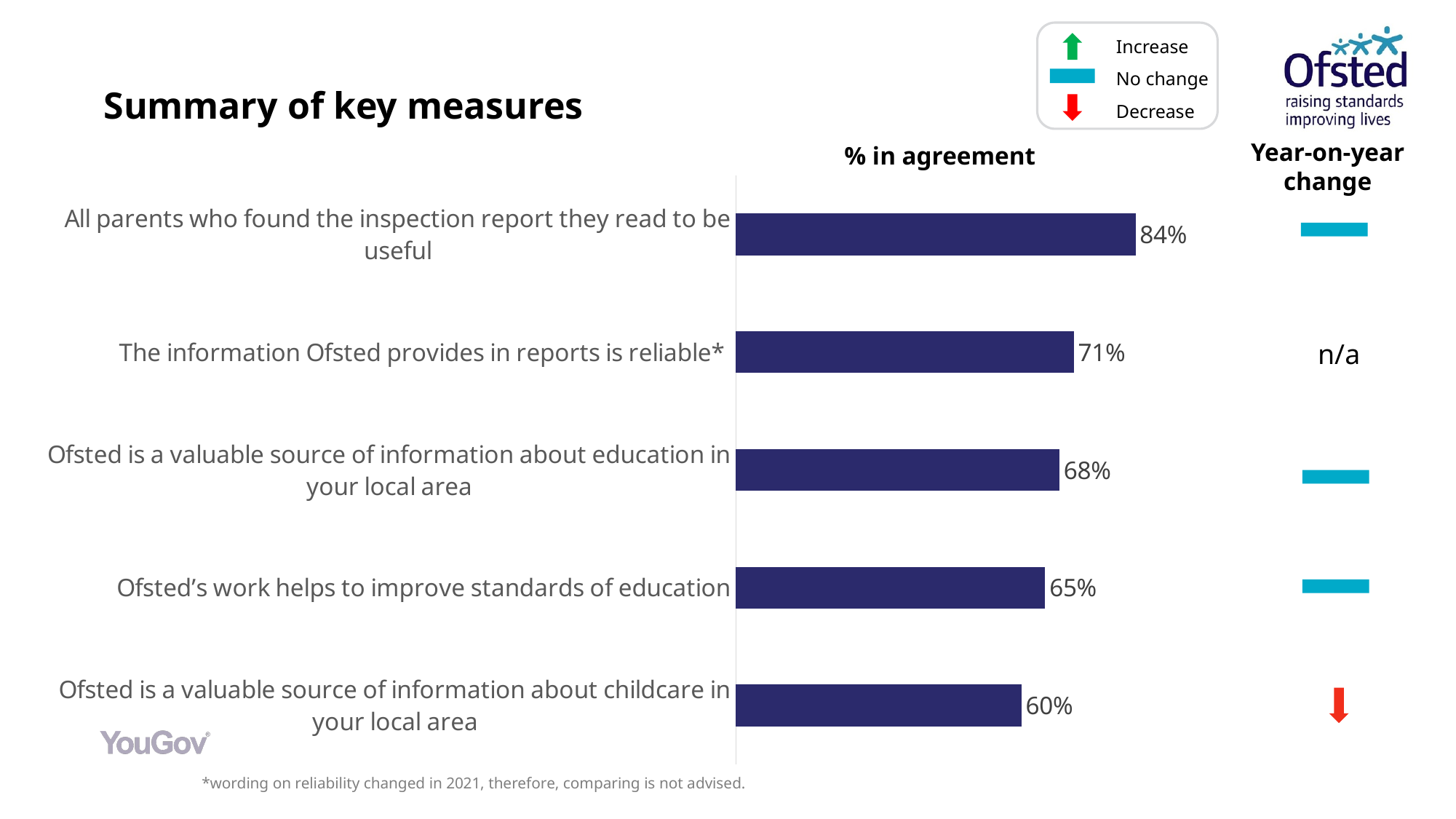
Which measure has the lowest % in agreement? Ofsted is a valuable source of information about childcare in your local area What is the difference in % in agreement between 'All parents who found the inspection report they read to be useful' and 'Ofsted is a valuable source of information about childcare in your local area'? 24% What kind of chart is shown on the slide? Bar chart What is the % in agreement for 'Ofsted is a valuable source of information about childcare in your local area'? 60% What is the % in agreement for 'Ofsted is a valuable source of information about education in your local area'? 68% What is the % in agreement for 'Ofsted's work helps to improve standards of education'? 65% What year-on-year change is shown for 'Ofsted is a valuable source of information about childcare in your local area'? Decrease Which has a higher % in agreement: 'Ofsted is a valuable source of information about education in your local area' or 'Ofsted's work helps to improve standards of education'? Ofsted is a valuable source of information about education in your local area What is the % in agreement for 'The information Ofsted provides in reports is reliable*'? 71% How many measures are plotted in the chart? 5 What percentage of parents who found the inspection report they read to be useful is shown? 84% Which measure has the highest % in agreement? All parents who found the inspection report they read to be useful